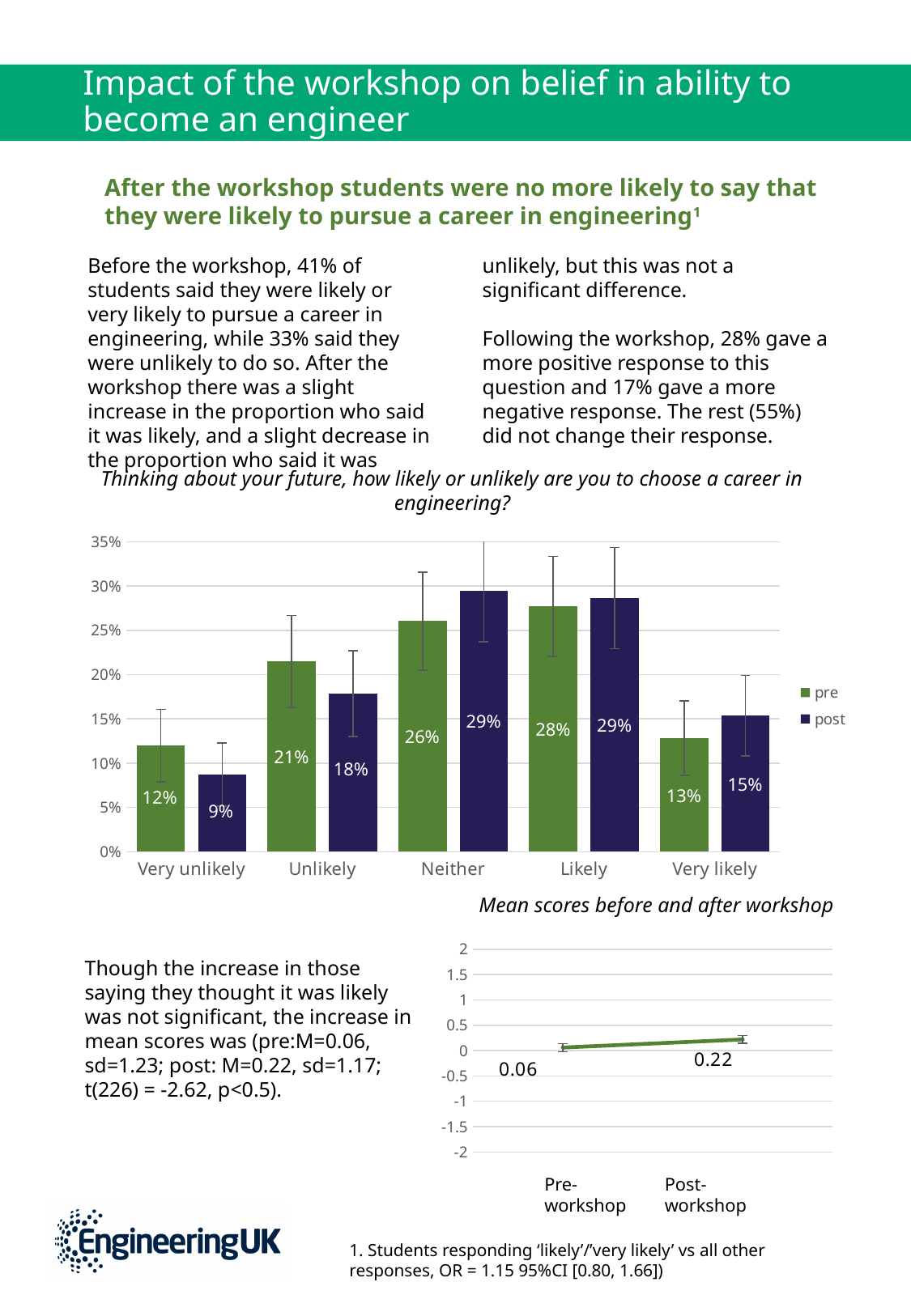
In the bar chart 'Thinking about your future, how likely or unlikely are you to choose a career in engineering?', how many series does the legend list? 2 In the bar chart 'Thinking about your future, how likely or unlikely are you to choose a career in engineering?', what is the difference between the pre and post values for Very unlikely? 3% In the bar chart 'Thinking about your future, how likely or unlikely are you to choose a career in engineering?', which category has the lowest post value? Very unlikely In the bar chart 'Thinking about your future, how likely or unlikely are you to choose a career in engineering?', which category has the highest pre value? Likely In the bar chart 'Thinking about your future, how likely or unlikely are you to choose a career in engineering?', what is the pre value for Unlikely? 21% In the bar chart 'Thinking about your future, how likely or unlikely are you to choose a career in engineering?', what colour are the post bars? Dark navy blue In the chart 'Mean scores before and after workshop', what is the value for Post-workshop? 0.22 In the bar chart 'Thinking about your future, how likely or unlikely are you to choose a career in engineering?', what is the post value for Very likely? 15% In the chart 'Mean scores before and after workshop', what is the difference between the Post-workshop and Pre-workshop values? 0.16 In the chart 'Mean scores before and after workshop', do the values rise or fall from Pre-workshop to Post-workshop? rise In the bar chart 'Thinking about your future, how likely or unlikely are you to choose a career in engineering?', is the pre value for Neither larger or smaller than the post value for Neither? smaller In the bar chart 'Thinking about your future, how likely or unlikely are you to choose a career in engineering?', how many categories are shown on the x axis? 5